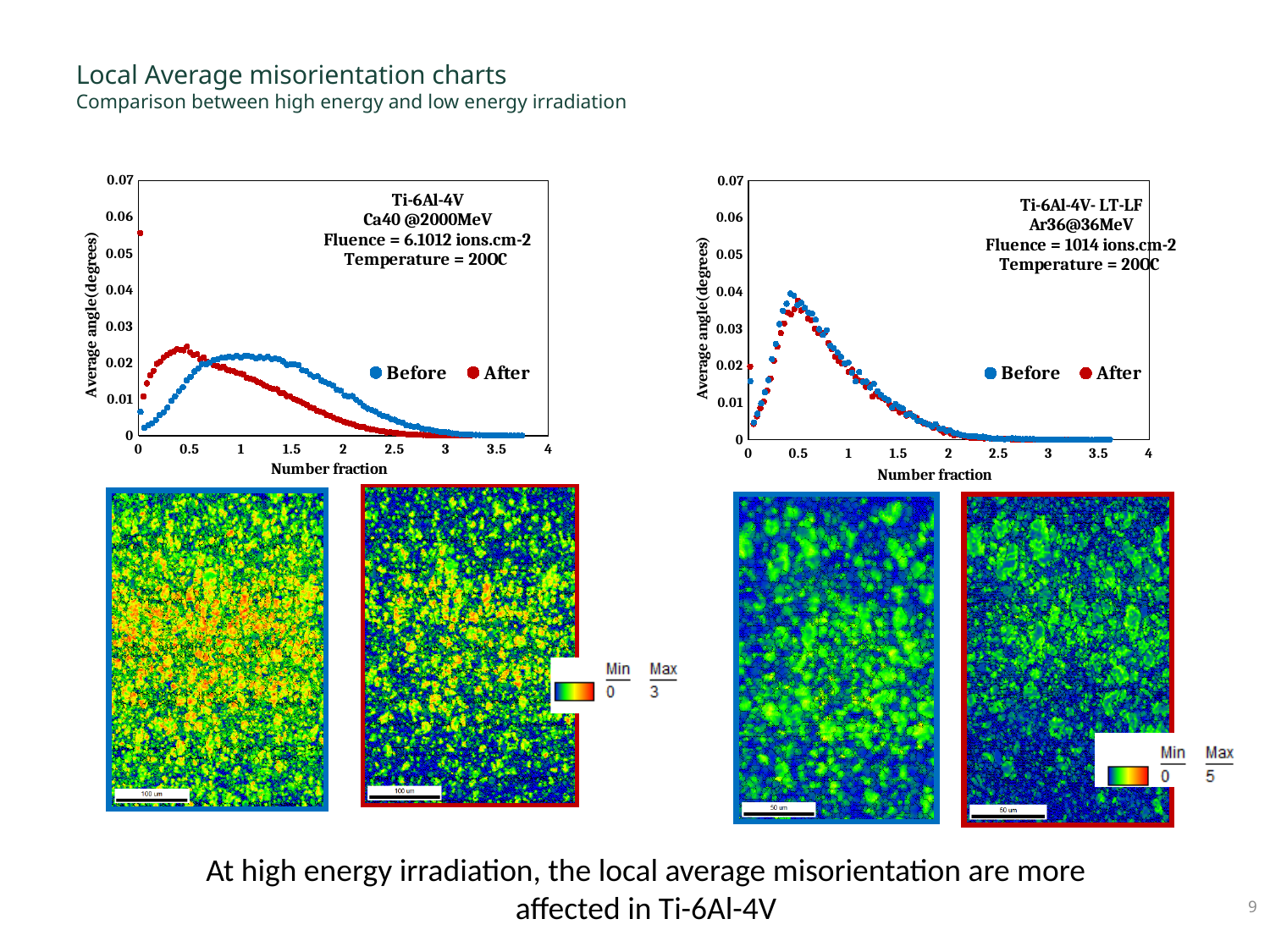
In the left chart (Ti-6Al-4V Ca40 @2000MeV), is the After value at a number fraction of 0 greater or less than 0.05? greater In the right chart (Ti-6Al-4V-LT-LF Ar36@36MeV), is the highest After value greater or less than 0.05? less In the right chart (Ti-6Al-4V-LT-LF Ar36@36MeV), is the highest Before value greater or less than 0.03? greater What kind of chart is the left chart (Ti-6Al-4V Ca40 @2000MeV)? scatter chart In the left chart (Ti-6Al-4V Ca40 @2000MeV), at a number fraction of 0.5, which series has the larger value, Before or After? After In the left chart (Ti-6Al-4V Ca40 @2000MeV), how many series does the legend list? 2 In the left chart (Ti-6Al-4V Ca40 @2000MeV), what is the label of the x axis? Number fraction In the left chart (Ti-6Al-4V Ca40 @2000MeV), do the After values rise or fall as the number fraction increases from 0.5 to 2.5? fall In the left chart (Ti-6Al-4V Ca40 @2000MeV), at a number fraction of 1.5, which series has the larger value, Before or After? Before In the right chart (Ti-6Al-4V-LT-LF Ar36@36MeV), what are the two series named in the legend? Before and After In the right chart (Ti-6Al-4V-LT-LF Ar36@36MeV), do the Before values rise or fall as the number fraction increases from 1 to 3? fall